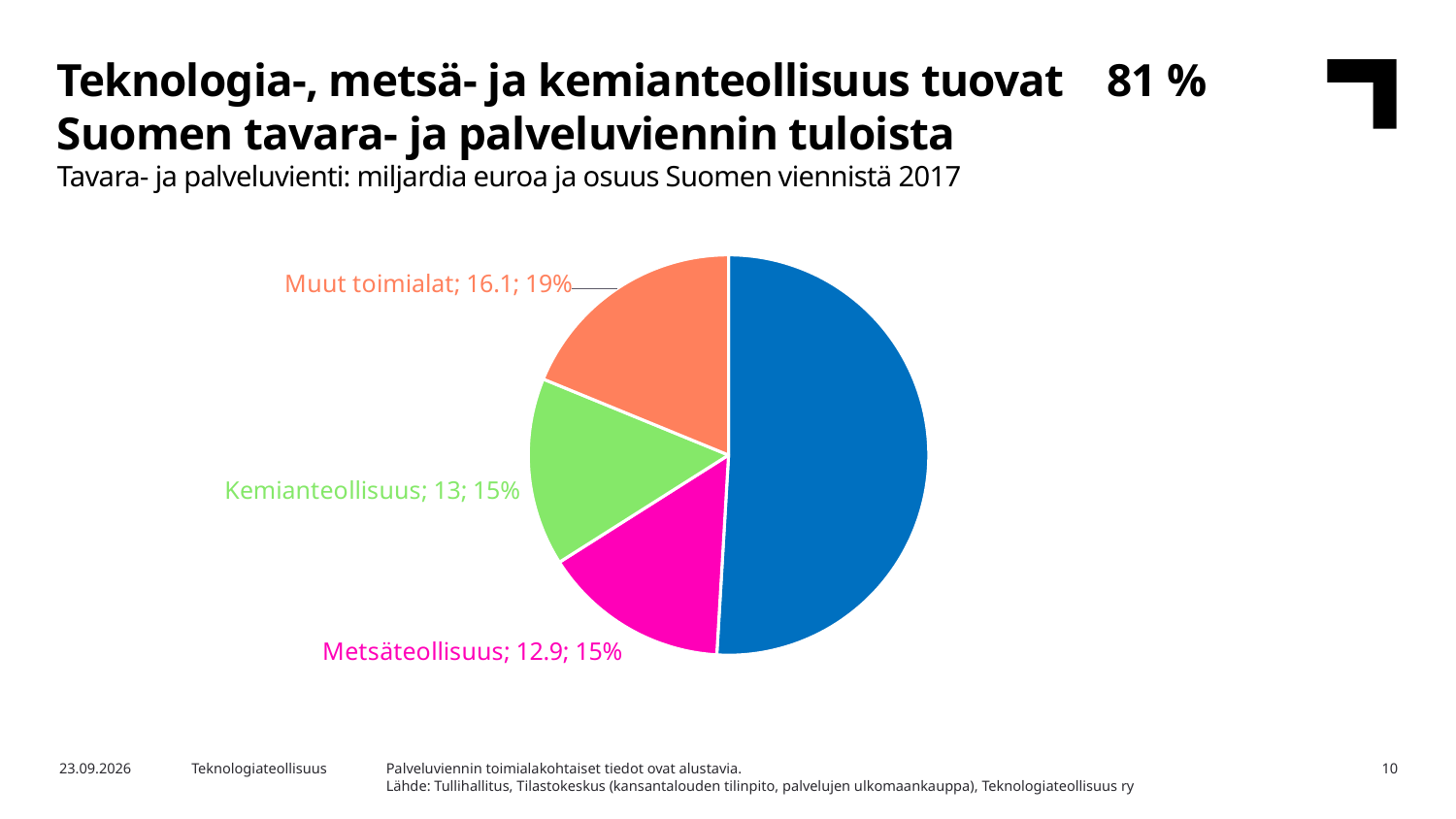
What kind of chart is shown on the slide? pie chart Of the labeled slices, which has the largest value? Muut toimialat What is the difference in billions of euros between Muut toimialat and Metsäteollisuus? 3.2 What is the value in billions of euros for Kemianteollisuus? 13 What share of Finland's exports does Kemianteollisuus account for? 15% What is the value in billions of euros for Metsäteollisuus? 12.9 What share of Finland's exports does Metsäteollisuus account for? 15% What is the value in billions of euros for Muut toimialat? 16.1 What colour is the Metsäteollisuus slice? magenta (pink) Which has the larger value, Muut toimialat or Kemianteollisuus? Muut toimialat What share of Finland's exports does Muut toimialat account for? 19% How many slices does the pie chart have? 4